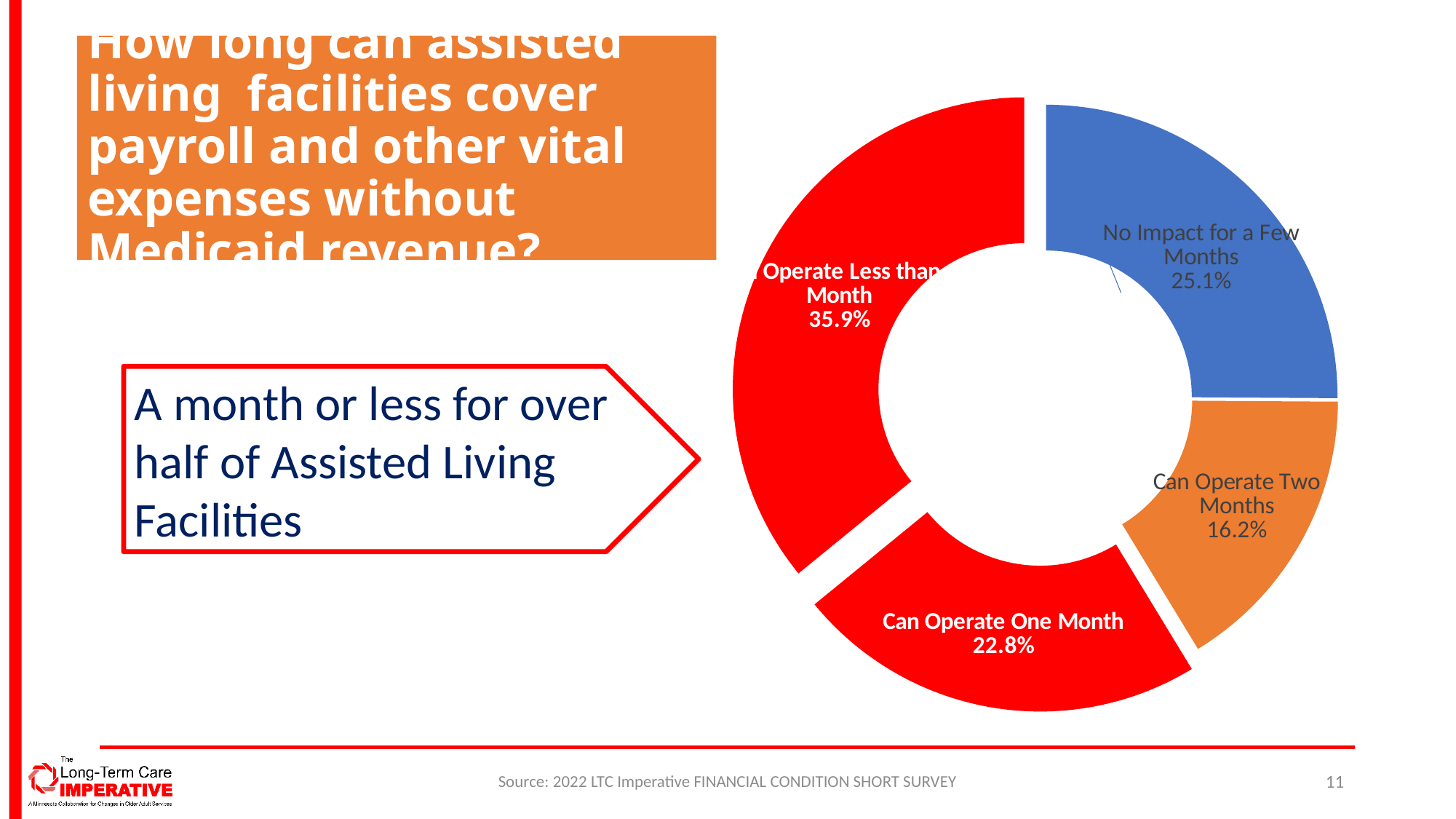
What percentage of assisted living facilities report 'No Impact for a Few Months'? 25.1% Which is larger, 'Can Operate One Month' or 'Can Operate Two Months'? Can Operate One Month What is the value for 'Can Operate Two Months'? 16.2% What is the value for 'Can Operate One Month'? 22.8% How many categories (slices) does the chart have? 4 Which category has the smallest share of the chart? Can Operate Two Months Which category has the largest share of the chart? Operate Less than a Month What is the combined share of the two red slices ('Operate Less than a Month' and 'Can Operate One Month')? 58.7% What colour is the 'Can Operate Two Months' slice? Orange What is the difference between 'No Impact for a Few Months' and 'Can Operate Two Months'? 8.9 percentage points What is the value for the 'Operate Less than a Month' slice? 35.9% What kind of chart is shown on the slide? Doughnut (pie) chart